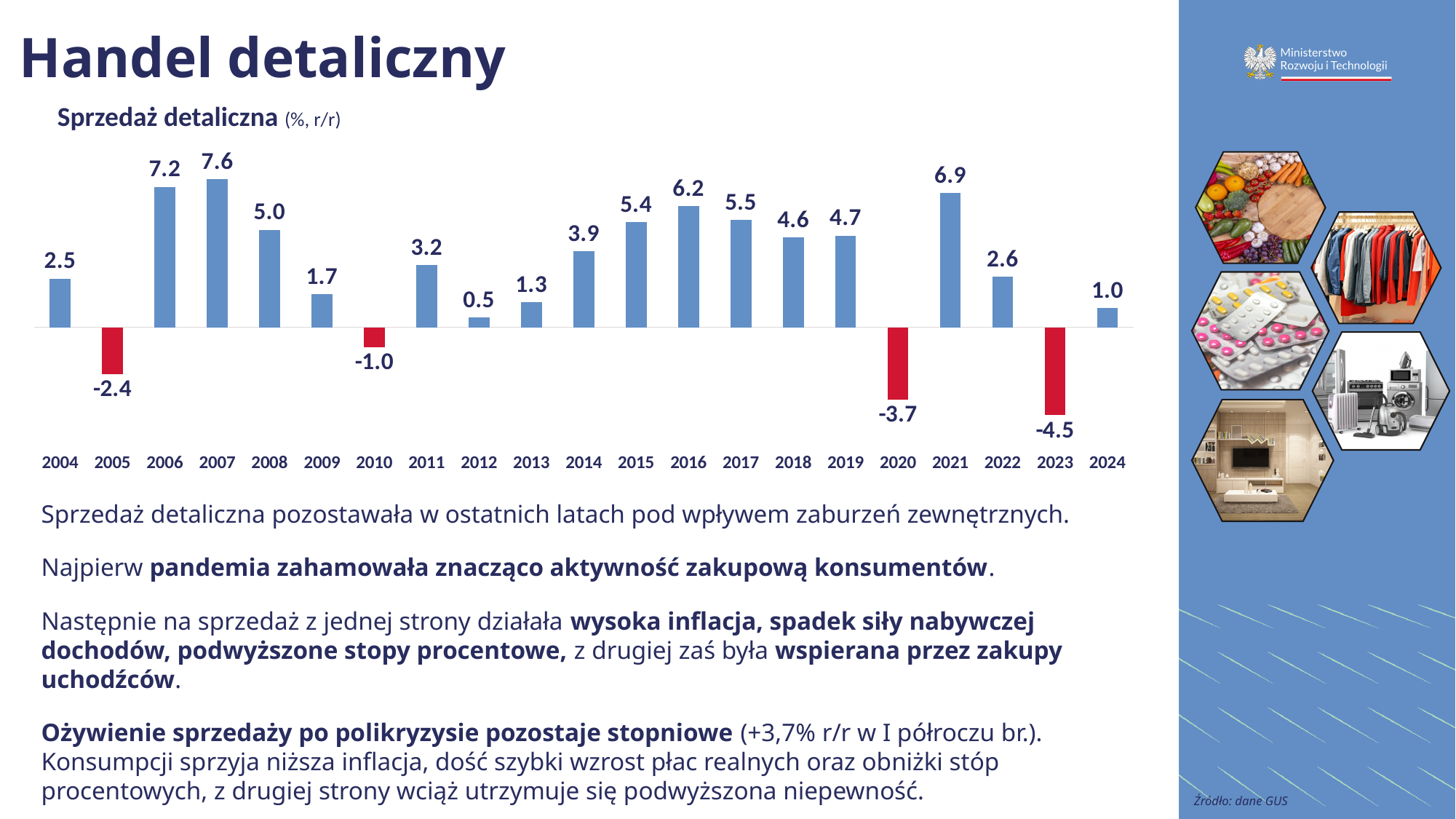
Do the values rise or fall from 2021 to 2023? fall How many years are shown on the x axis? 21 How many years have a negative value? 4 What kind of chart is this? bar chart What is the title of the chart? Sprzedaż detaliczna (%, r/r) What is the value for 2020? -3.7 What is the value for 2007? 7.6 Which year has the lowest value? 2023 What is the difference between the values for 2021 and 2022? 4.3 Which is larger, the value for 2016 or the value for 2017? 2016 Which year has the highest value? 2007 What is the value for 2024? 1.0